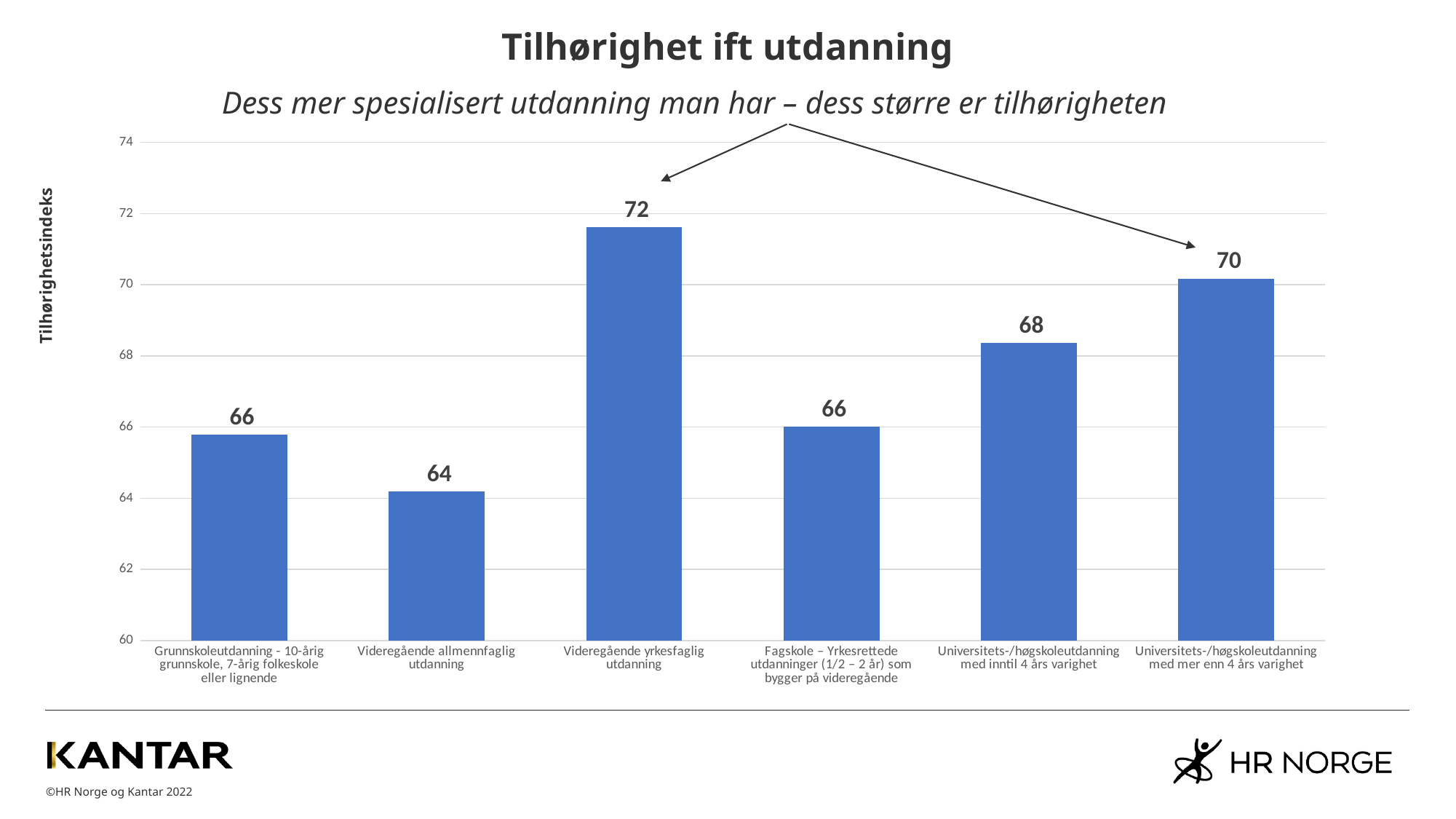
What is the label on the vertical axis of the chart? Tilhørighetsindeks What is the value for Videregående yrkesfaglig utdanning? 72 Which is larger: the value for Universitets-/høgskoleutdanning med mer enn 4 års varighet or the value for Universitets-/høgskoleutdanning med inntil 4 års varighet? Universitets-/høgskoleutdanning med mer enn 4 års varighet What is the value for Videregående allmennfaglig utdanning? 64 Which category has the highest value? Videregående yrkesfaglig utdanning What is the difference between the values for Videregående yrkesfaglig utdanning and Videregående allmennfaglig utdanning? 8 Which category has the lowest value? Videregående allmennfaglig utdanning What is the value for Universitets-/høgskoleutdanning med inntil 4 års varighet? 68 How many categories are shown in the chart? 6 What kind of chart is shown on the slide? bar chart Is the value for Fagskole – Yrkesrettede utdanninger greater or less than 68? less What is the value for Universitets-/høgskoleutdanning med mer enn 4 års varighet? 70